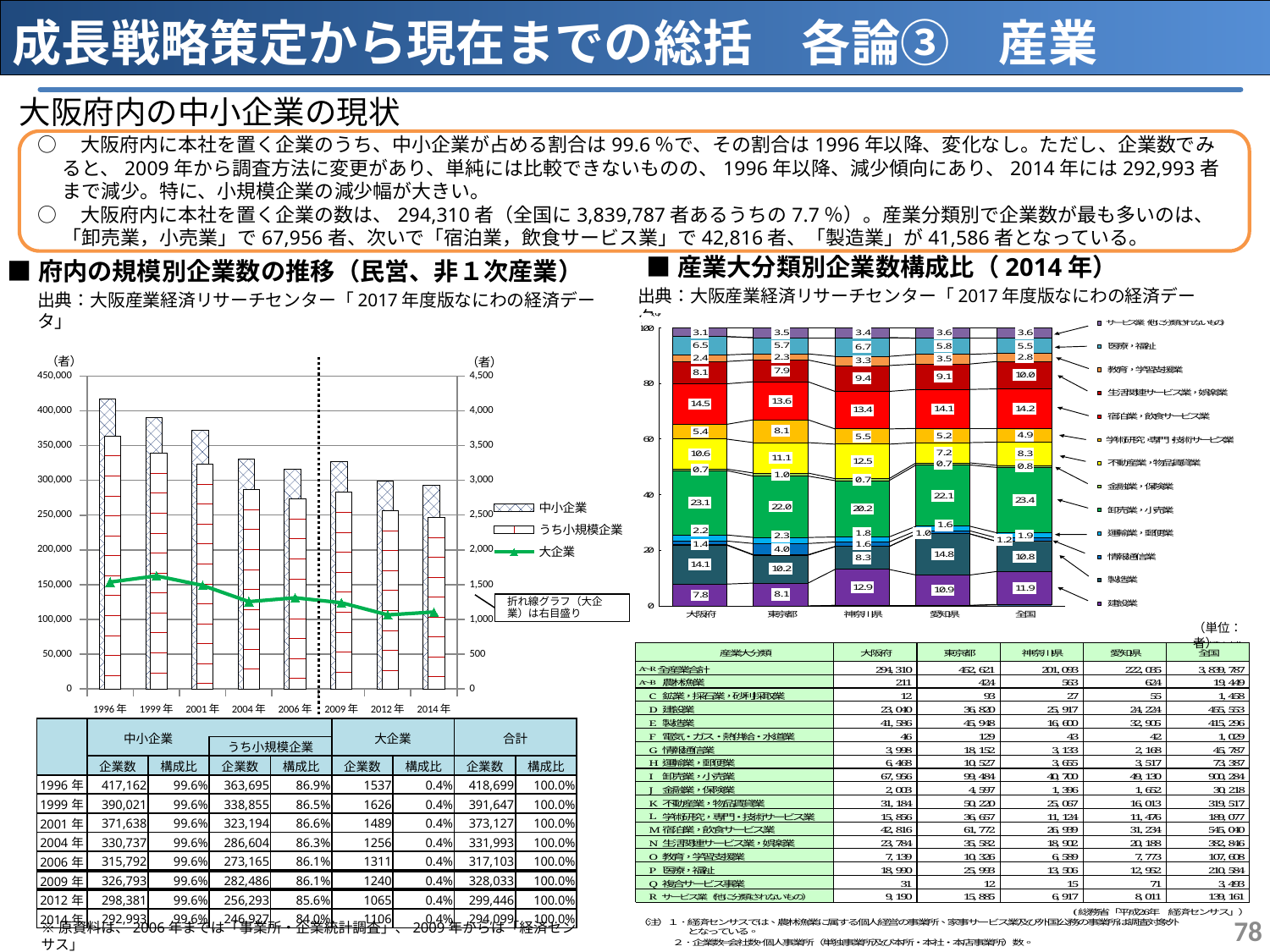
In the chart titled 産業大分類別企業数構成比（2014年）, which is larger: the 不動産業・物品賃貸業 value for 神奈川県 or for 愛知県? 神奈川県 In the chart titled 産業大分類別企業数構成比（2014年）, how many series does the legend list? 13 In the chart titled 産業大分類別企業数構成比（2014年）, what is the value for 製造業 in 愛知県? 14.8 In the chart titled 産業大分類別企業数構成比（2014年）, which region has the highest value for 建設業? 神奈川県 In the chart titled 産業大分類別企業数構成比（2014年）, how many regions are shown on the x axis? 5 In the chart titled 産業大分類別企業数構成比（2014年）, what is the difference between the 情報通信業 values for 東京都 and 大阪府? 2.6 In the chart titled 府内の規模別企業数の推移（民営、非１次産業）, how many series does the legend list? 3 In the chart titled 府内の規模別企業数の推移（民営、非１次産業）, is the 中小企業 value for 1996年 greater or less than 400,000? greater In the chart titled 産業大分類別企業数構成比（2014年）, what is the value for 卸売業・小売業 in 大阪府? 23.1 In the chart titled 府内の規模別企業数の推移（民営、非１次産業）, how many years are shown on the x axis? 8 What kind of chart is the one titled 産業大分類別企業数構成比（2014年）? Stacked bar chart In the chart titled 産業大分類別企業数構成比（2014年）, which region has the lowest value for 製造業? 神奈川県